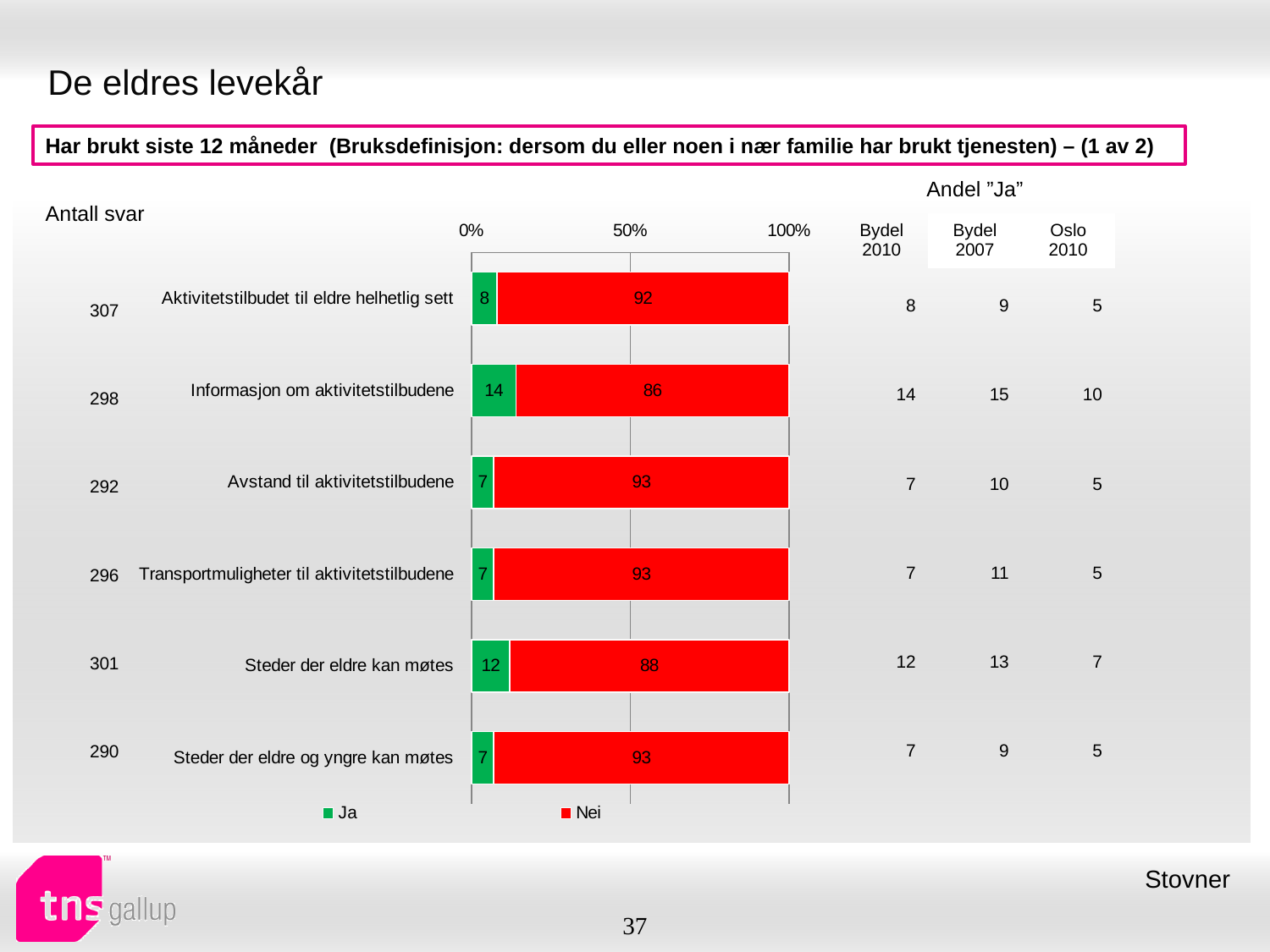
Which category has the lowest "Nei" value? Informasjon om aktivitetstilbudene What is the "Nei" value for "Aktivitetstilbudet til eldre helhetlig sett"? 92 What is the "Ja" value for "Informasjon om aktivitetstilbudene"? 14 Which category has the highest "Ja" value? Informasjon om aktivitetstilbudene What is the "Nei" value for "Avstand til aktivitetstilbudene"? 93 What is the total of the stacked bar for "Steder der eldre og yngre kan møtes"? 100 What is the "Ja" value for "Steder der eldre kan møtes"? 12 How many series does the chart legend list? 2 What kind of chart is shown on the slide? bar chart How many categories are plotted in the chart? 6 Which is larger: the "Ja" value for "Steder der eldre kan møtes" or the "Ja" value for "Aktivitetstilbudet til eldre helhetlig sett"? Steder der eldre kan møtes What is the difference between the "Ja" values for "Informasjon om aktivitetstilbudene" and "Steder der eldre kan møtes"? 2